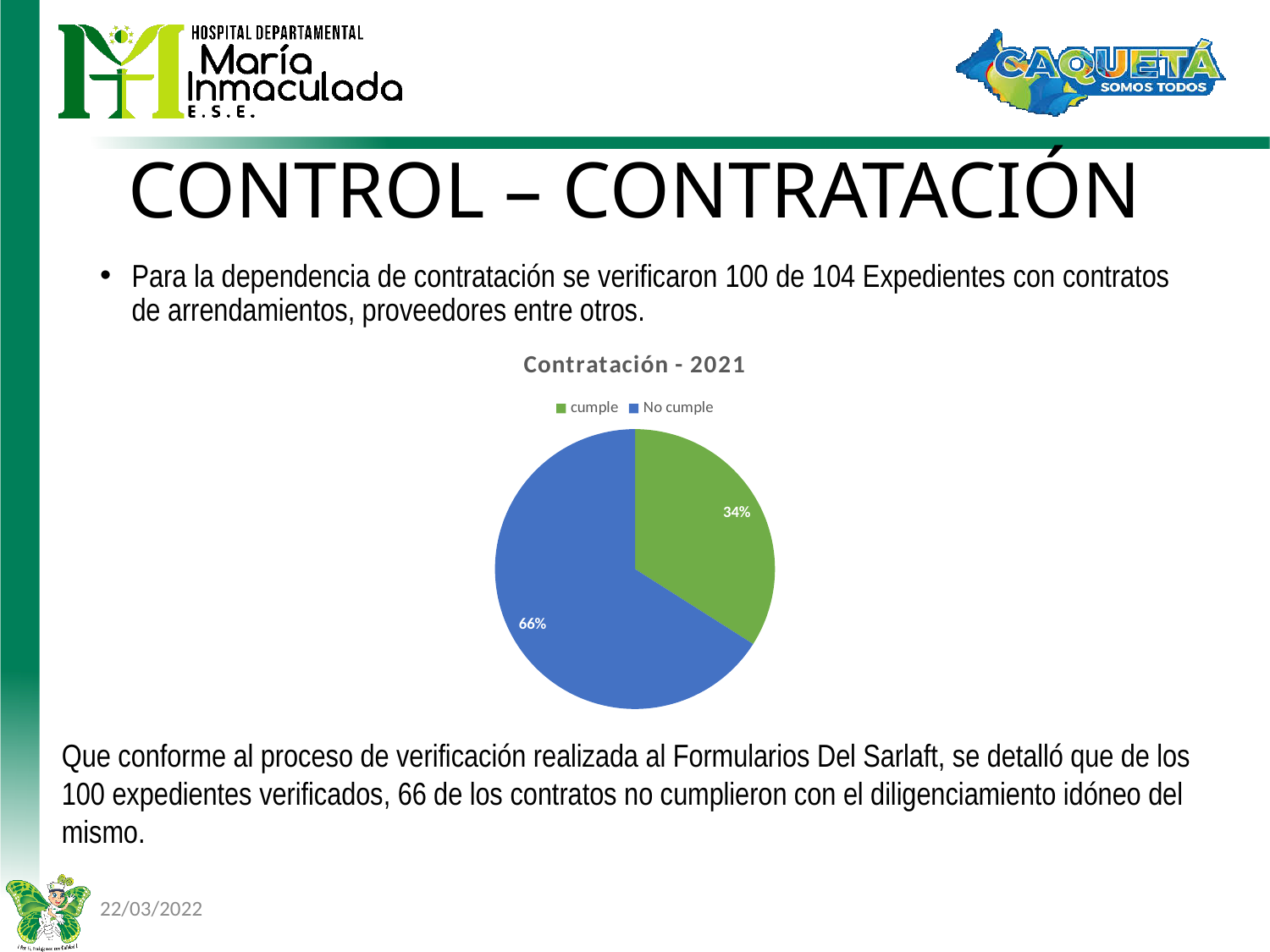
What percentage of the pie is labelled "No cumple"? 66% What is the title of the pie chart? Contratación - 2021 How many entries does the legend list? 2 Which category has the smallest share of the pie? cumple Which category has the largest share of the pie? No cumple What percentage of the pie is labelled "cumple"? 34% What colour is the "No cumple" slice? blue What kind of chart is shown on the slide? pie chart What is the share of the pie taken by the "cumple" slice? 34% How many categories does the pie chart show? 2 What is the difference in percentage points between "No cumple" and "cumple"? 32 Which is larger, the share for "cumple" or the share for "No cumple"? No cumple